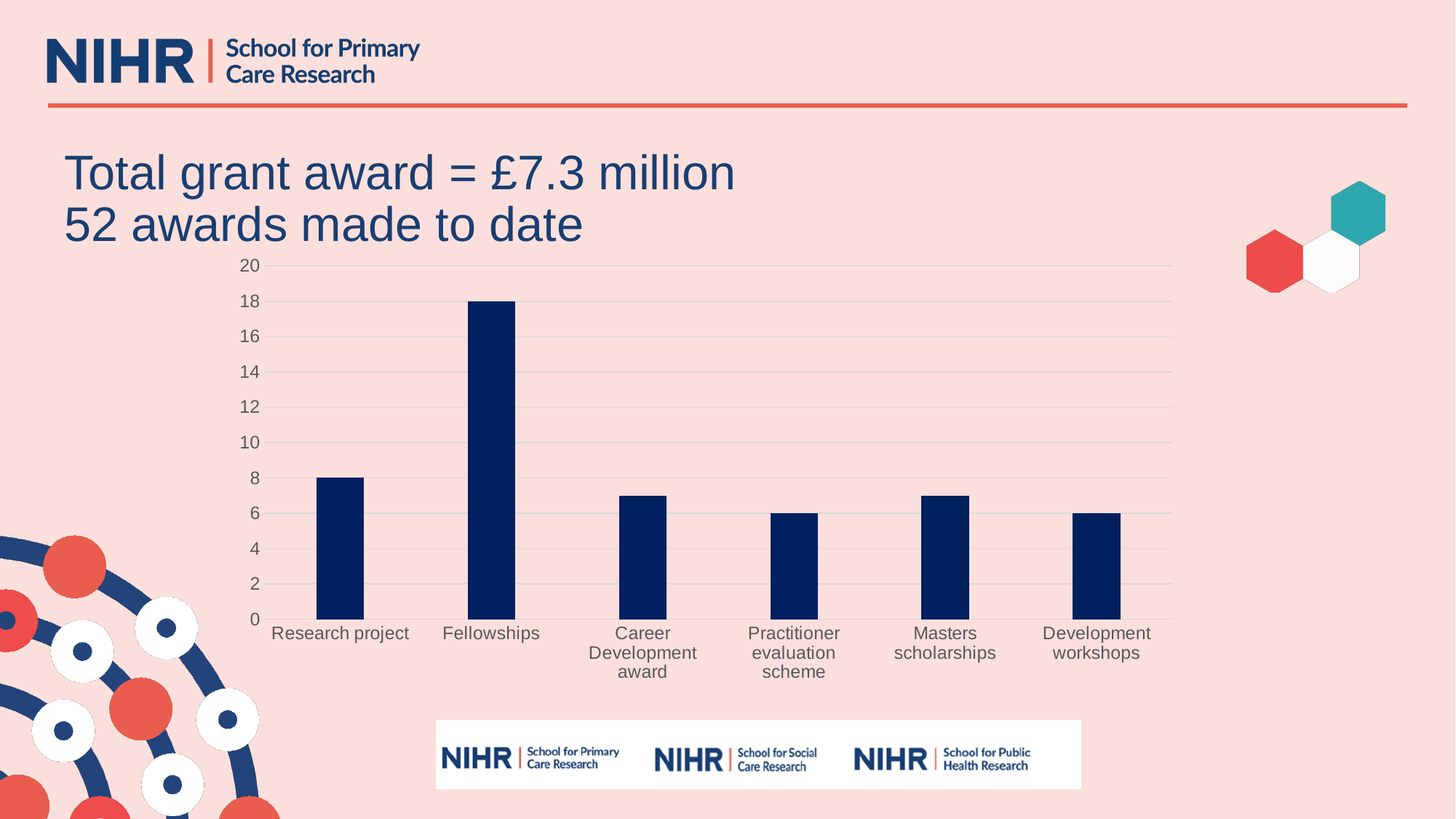
What is the difference between the values for Fellowships and Research project? 10 What is the value for Development workshops? 6 What colour are the bars in the chart? Dark navy blue What is the value for Practitioner evaluation scheme? 6 How many categories are shown on the x axis of the chart? 6 Which category has the highest bar in the chart? Fellowships Is the value for Career Development award greater or less than 8? less What is the value for Fellowships? 18 What is the value for Research project? 8 What kind of chart is shown on the slide? Bar chart Is the value for Masters scholarships greater or less than 6? greater Which is larger, the value for Fellowships or the value for Research project? Fellowships